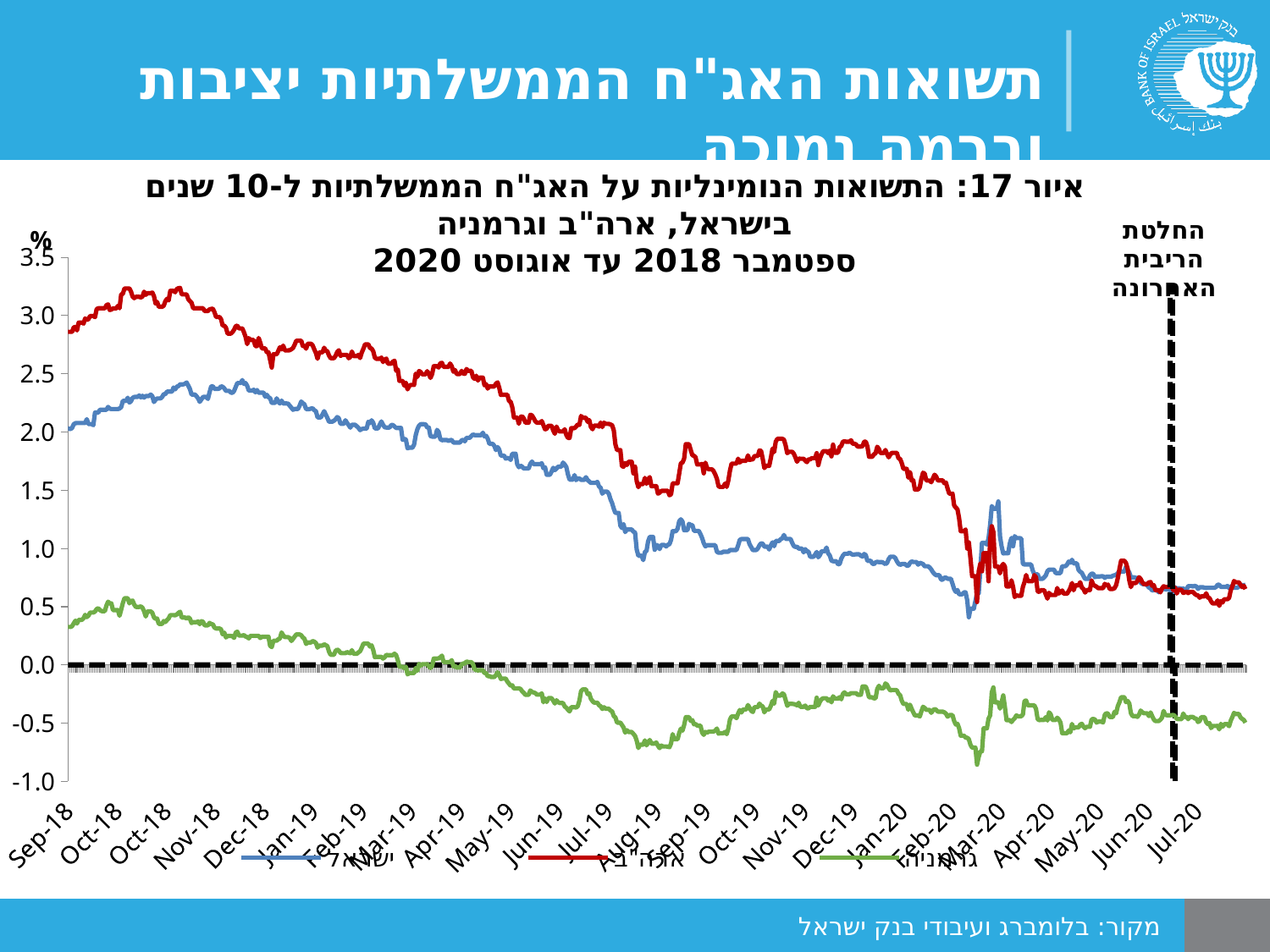
Which series has the highest value at Sep-18? ארה"ב What kind of chart is shown on the slide? line chart At Jul-20, is the value for ארה"ב greater or less than 1.0? less Which series has the lowest values throughout the chart? גרמניה How many series does the legend list? 3 At Sep-18, is the value for גרמניה greater or less than 0.5? less Do the values for ארה"ב rise or fall overall from Sep-18 to Jul-20? fall What does the vertical dashed line on the right of the chart mark? החלטת הריבית האחרונה At Sep-18, is the value for ארה"ב greater or less than 2.5? greater At Sep-18, which is larger, the value for ארה"ב or the value for ישראל? ארה"ב Which series is plotted in red? ארה"ב